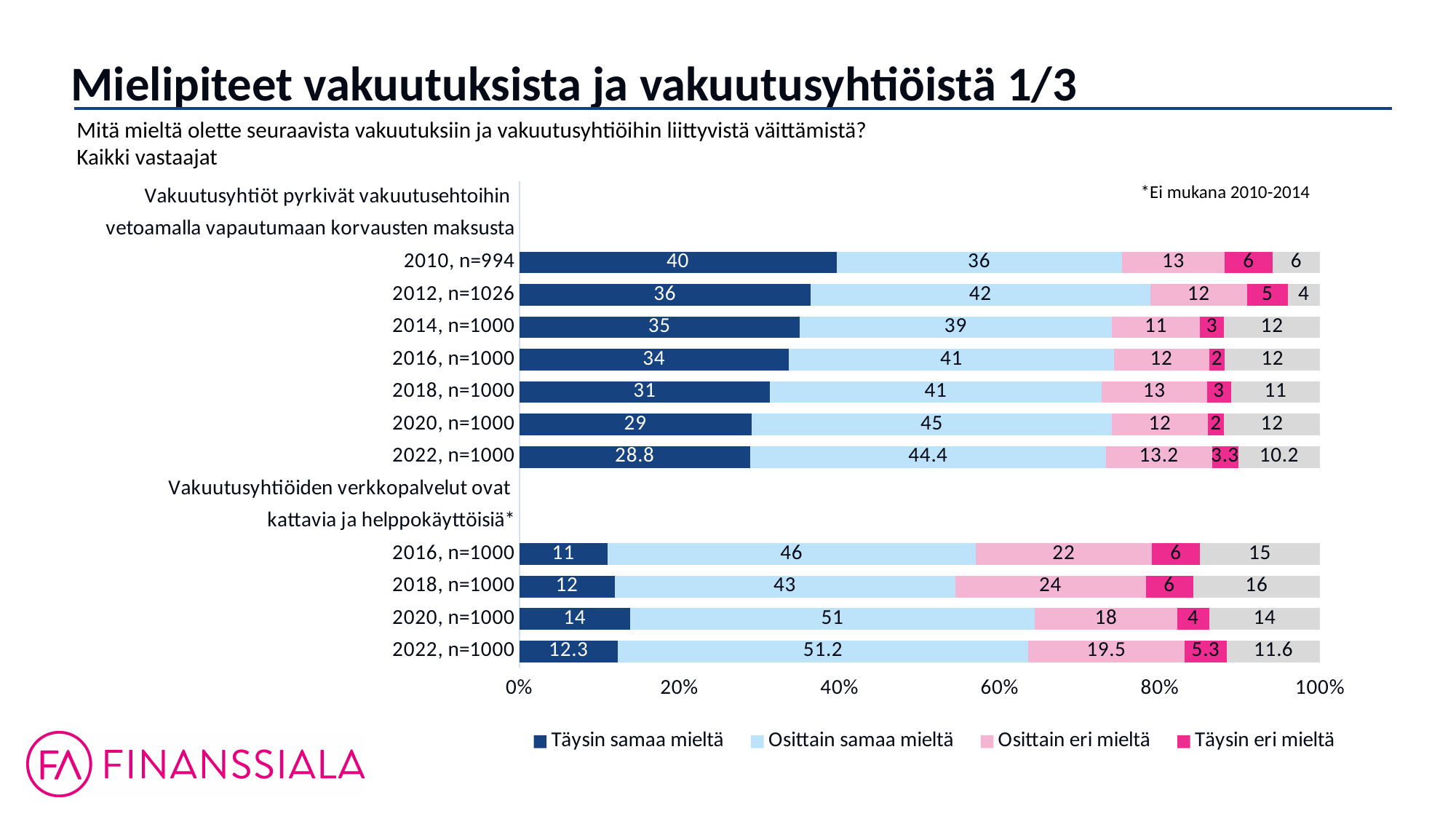
Under the statement 'Vakuutusyhtiöiden verkkopalvelut ovat kattavia ja helppokäyttöisiä', which year has the lowest 'Täysin samaa mieltä' value? 2016, n=1000 How many year rows are shown under the statement 'Vakuutusyhtiöiden verkkopalvelut ovat kattavia ja helppokäyttöisiä'? 4 How does the 'Täysin samaa mieltä' value change from 2010 to 2022 under the statement 'Vakuutusyhtiöt pyrkivät vakuutusehtoihin vetoamalla vapautumaan korvausten maksusta'? It falls How many series does the legend list? 4 Under the statement 'Vakuutusyhtiöt pyrkivät vakuutusehtoihin vetoamalla vapautumaan korvausten maksusta', what is the difference between the 'Täysin samaa mieltä' values for 2010 and 2020? 11 What is the 'Osittain samaa mieltä' value for 2022, n=1000 under the statement 'Vakuutusyhtiöiden verkkopalvelut ovat kattavia ja helppokäyttöisiä'? 51.2 What is the 'Täysin samaa mieltä' value for 2010, n=994 under the statement 'Vakuutusyhtiöt pyrkivät vakuutusehtoihin vetoamalla vapautumaan korvausten maksusta'? 40 What is the first legend entry of the chart? Täysin samaa mieltä What kind of chart is shown on the slide? Stacked bar chart Under the statement 'Vakuutusyhtiöiden verkkopalvelut ovat kattavia ja helppokäyttöisiä', which is larger: the 'Osittain eri mieltä' value for 2018 or for 2020? 2018 What is the 'Täysin eri mieltä' value for 2022, n=1000 under the statement 'Vakuutusyhtiöt pyrkivät vakuutusehtoihin vetoamalla vapautumaan korvausten maksusta'? 3.3 Under the statement 'Vakuutusyhtiöt pyrkivät vakuutusehtoihin vetoamalla vapautumaan korvausten maksusta', which year has the highest 'Täysin samaa mieltä' value? 2010, n=994